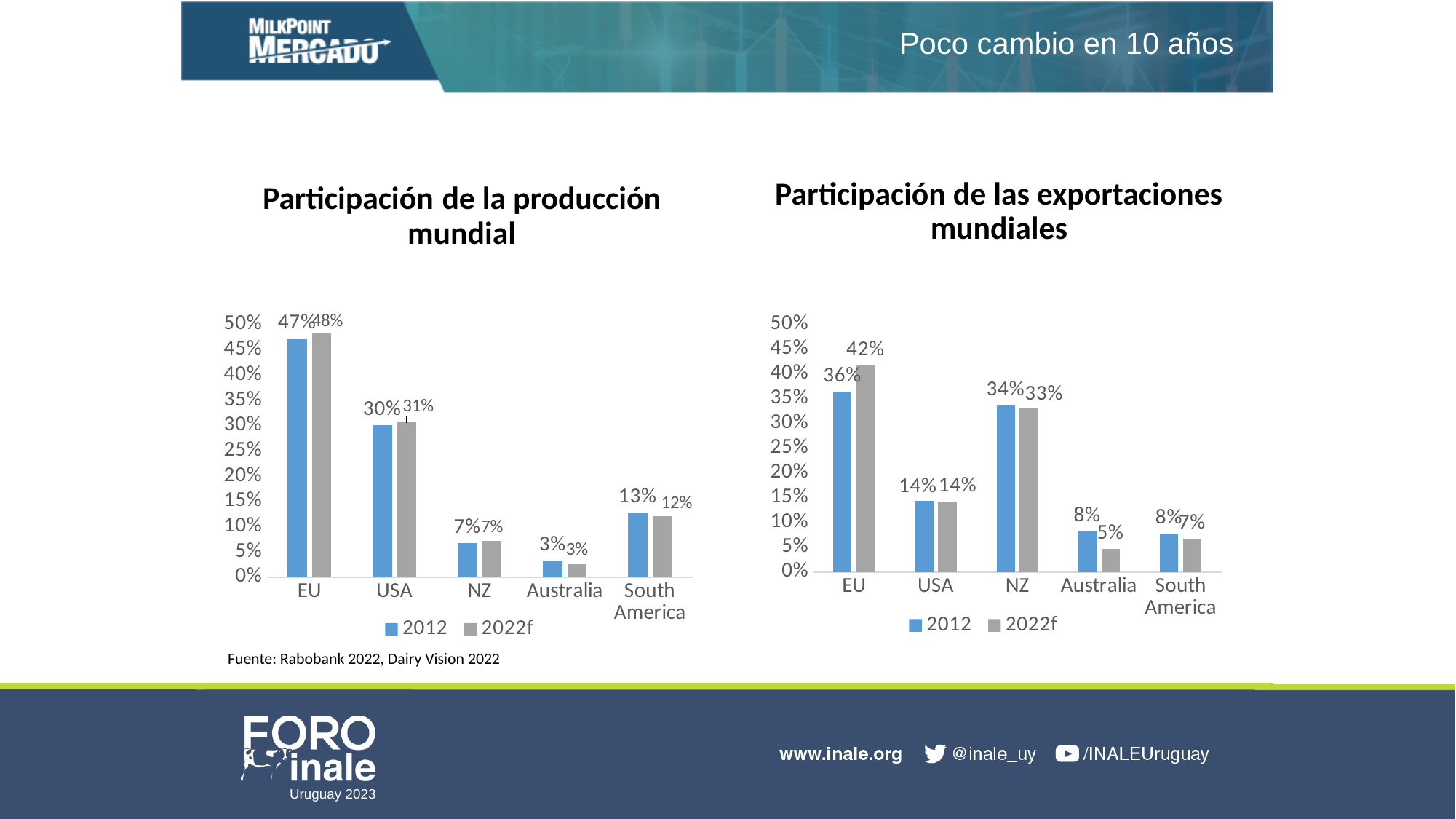
How many series does the legend of the 'Participación de las exportaciones mundiales' chart list? 2 In the 'Participación de las exportaciones mundiales' chart, which is larger for NZ: the 2012 value or the 2022f value? 2012 How many categories are shown on the x axis of the 'Participación de la producción mundial' chart? 5 What are the legend entries of the 'Participación de la producción mundial' chart? 2012 and 2022f What kind of chart is the 'Participación de las exportaciones mundiales' chart? Bar chart In the 'Participación de la producción mundial' chart, what is the 2012 value for EU? 47% In the 'Participación de las exportaciones mundiales' chart, what is the 2022f value for EU? 42% In the 'Participación de la producción mundial' chart, which category has the lowest 2022f value? Australia In the 'Participación de la producción mundial' chart, what is the 2022f value for South America? 12% In the 'Participación de las exportaciones mundiales' chart, what is the 2012 value for Australia? 8% In the 'Participación de la producción mundial' chart, which category has the highest 2012 value? EU In the 'Participación de las exportaciones mundiales' chart, what is the difference between the 2022f and 2012 values for EU? 6%